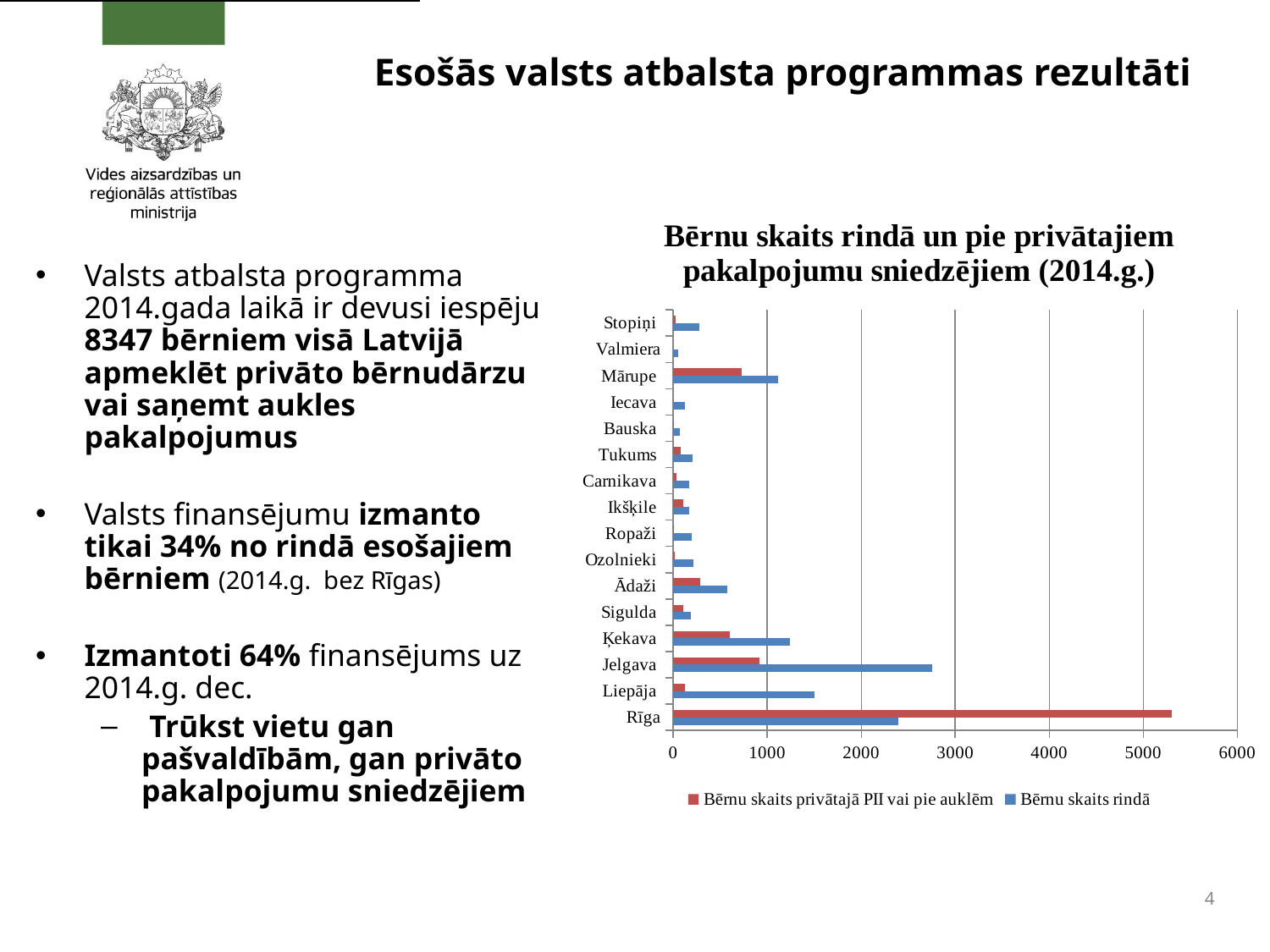
What is the title of the chart? Bērnu skaits rindā un pie privātajiem pakalpojumu sniedzējiem (2014.g.) Is the value of 'Bērnu skaits privātajā PII vai pie auklēm' for Mārupe greater or less than 1000? less For Rīga, which is larger: 'Bērnu skaits privātajā PII vai pie auklēm' or 'Bērnu skaits rindā'? Bērnu skaits privātajā PII vai pie auklēm For Jelgava, which is larger: 'Bērnu skaits rindā' or 'Bērnu skaits privātajā PII vai pie auklēm'? Bērnu skaits rindā Is the value of 'Bērnu skaits rindā' for Rīga greater or less than 2000? greater Which municipality has the highest value for 'Bērnu skaits rindā'? Jelgava What kind of chart is shown on the slide? bar chart How many series does the chart legend list? 2 Is the value of 'Bērnu skaits rindā' for Jelgava greater or less than 3000? less How many municipalities (categories) are shown on the chart? 16 Which municipality has the highest value for 'Bērnu skaits privātajā PII vai pie auklēm'? Rīga